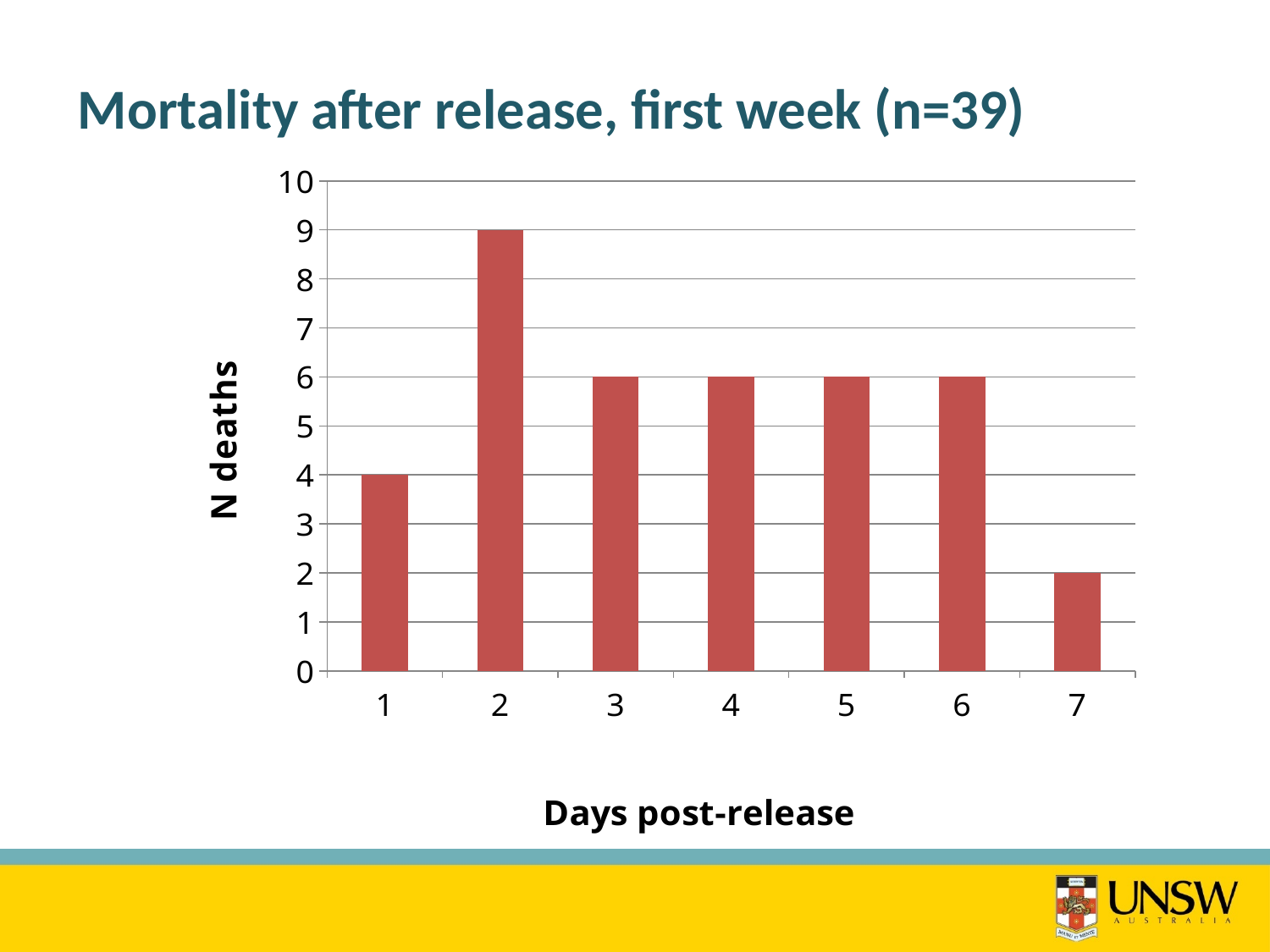
Is the number of deaths on day 2 greater or less than 8? greater How many deaths occurred on day 7 post-release? 2 Which day post-release has the lowest number of deaths? 7 How many deaths occurred on day 1 post-release? 4 What is the title of the chart? Mortality after release, first week (n=39) What is the label of the y axis? N deaths What is the difference in deaths between day 2 and day 1 post-release? 5 How many days post-release are shown on the x axis? 7 How many deaths occurred on day 2 post-release? 9 Which has more deaths, day 1 or day 3 post-release? day 3 What kind of chart is shown on the slide? bar chart Which day post-release has the highest number of deaths? 2